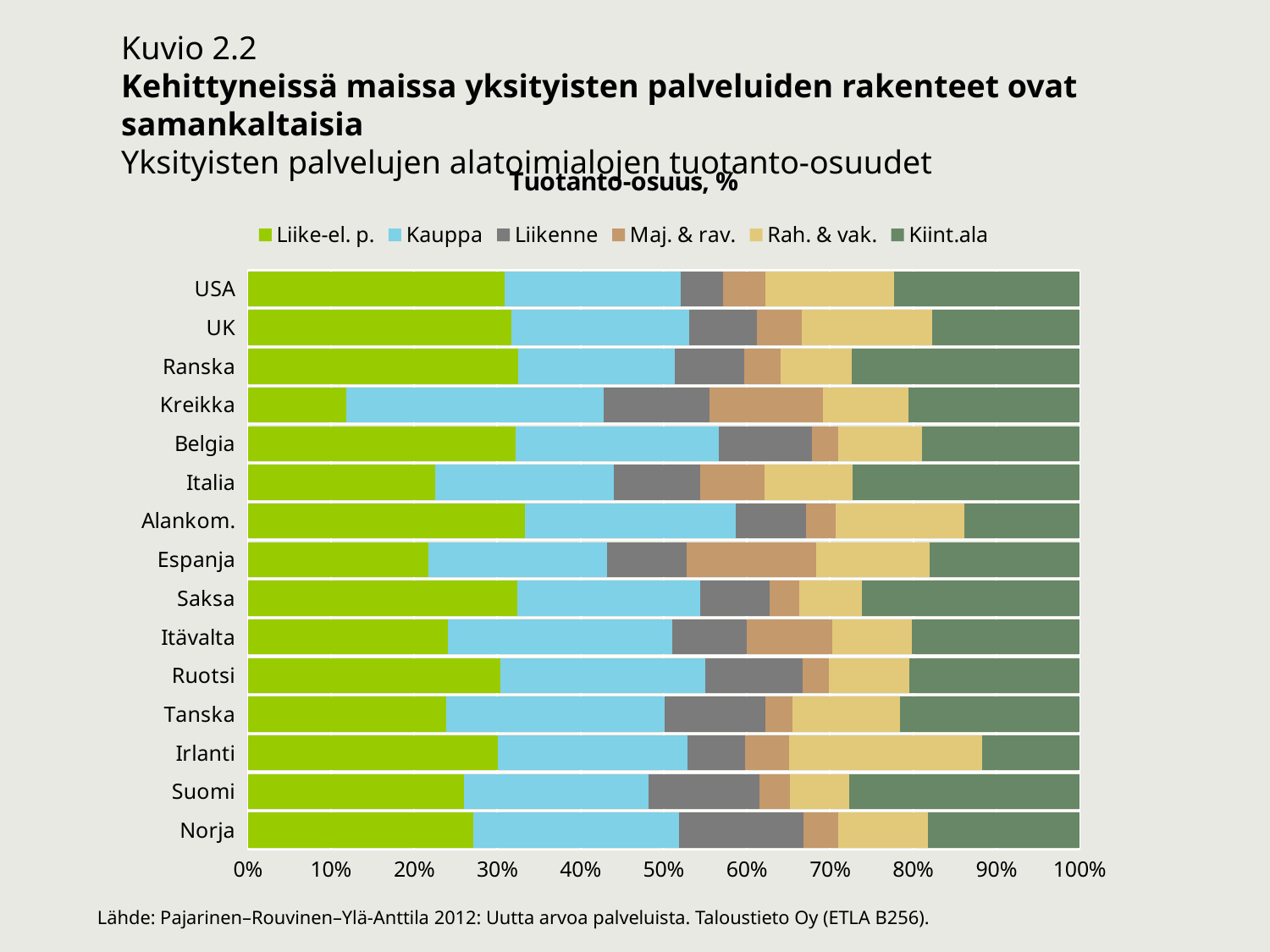
Which country has the smallest Liike-el. p. share? Kreikka Is the Liike-el. p. share for Kreikka greater or less than 20%? less What is the title printed above the chart legend? Tuotanto-osuus, % Which country has the largest Rah. & vak. share? Irlanti Which country has the larger Maj. & rav. share, Espanja or Saksa? Espanja How many series does the chart legend list? 6 What kind of chart is shown on the slide? Stacked bar chart Is the Kauppa share for Kreikka greater or less than 20%? greater How many countries are listed on the vertical axis of the chart? 15 Is the Kiint.ala share for Irlanti greater or less than 20%? less Which series is listed first in the chart legend? Liike-el. p. Which country has the larger Liike-el. p. share, Kreikka or Italia? Italia